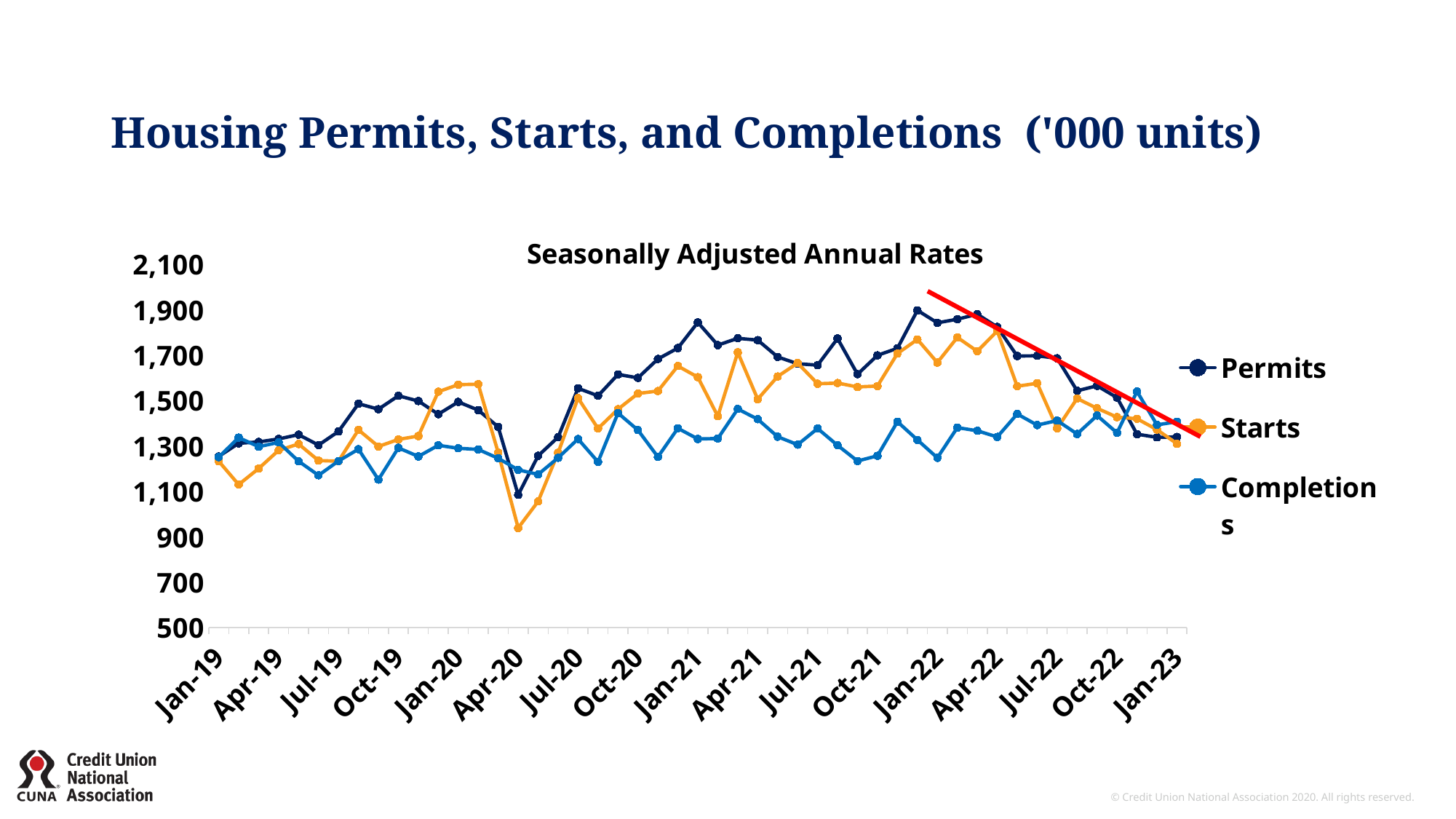
Is the value for Completions at Jul-19 greater or less than 1,300? less At which x-axis label does the Starts series reach its lowest value? Apr-20 Do the Permits values rise or fall from Apr-22 to Jan-23? Fall How many series does the legend list? 3 At Apr-20, which series is higher: Starts or Completions? Completions What kind of chart is shown on the slide? Line chart What is the title shown above the chart's plot area? Seasonally Adjusted Annual Rates Which series is drawn in orange? Starts At Jan-22, which series is higher: Permits or Completions? Permits Is the value for Starts at Apr-20 greater or less than 1,100? less Is the value for Permits at Jan-22 greater or less than 1,700? greater